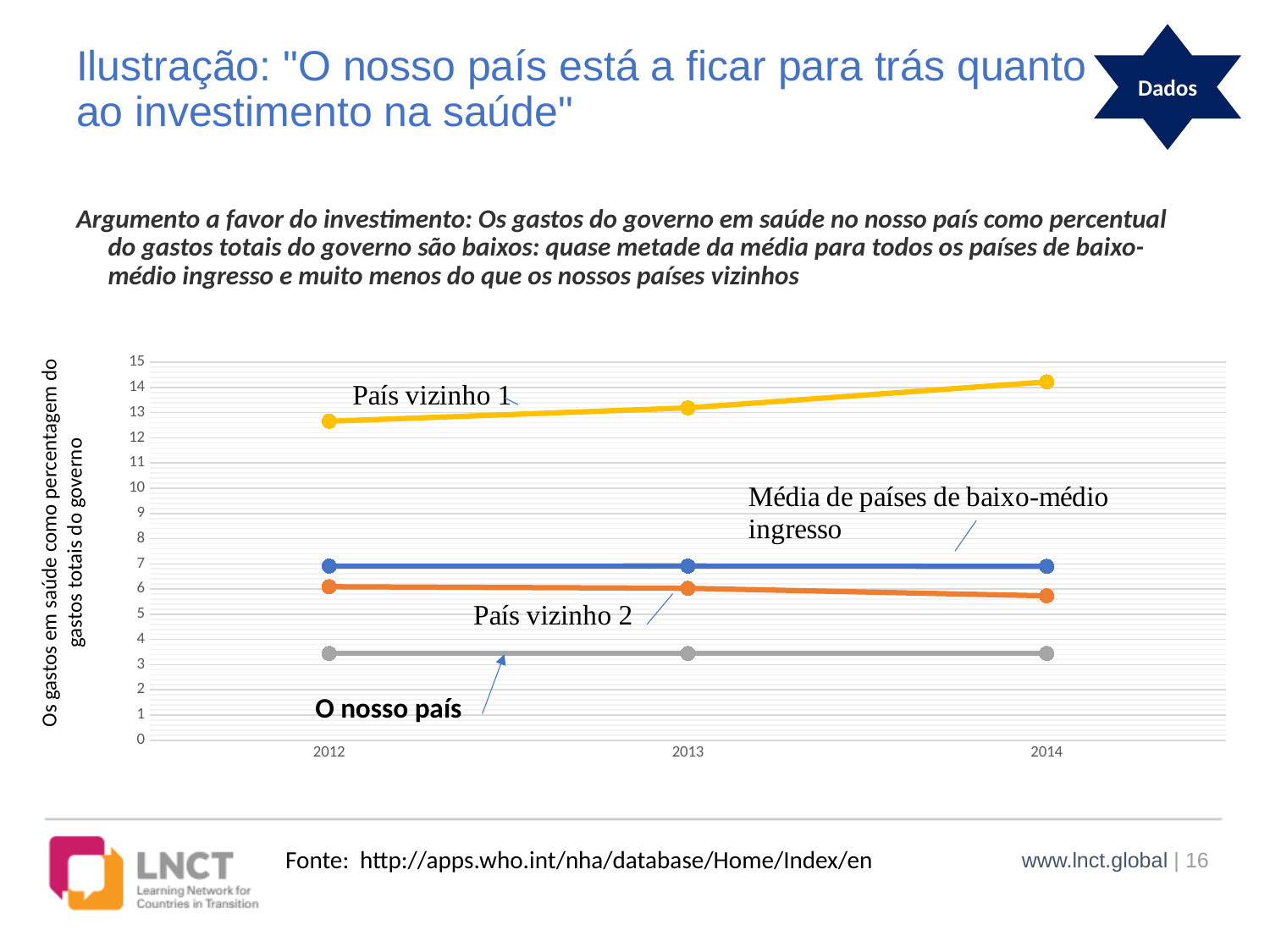
Is the value for O nosso país in 2013 greater or less than 4? less Which series has the lowest value in 2012? O nosso país How many years are shown on the x axis of the chart? 3 Which is larger in 2014: the value for País vizinho 2 or the value for O nosso país? País vizinho 2 Is the value for País vizinho 1 in 2014 greater or less than 14? greater Does the value for País vizinho 1 rise or fall from 2012 to 2014? rise Is the value for Média de países de baixo-médio ingresso in 2014 greater or less than 8? less What is the label on the vertical axis of the chart? Os gastos em saúde como percentagem do gastos totais do governo What kind of chart is shown on the slide? line chart Which is larger in 2012: the value for Média de países de baixo-médio ingresso or the value for País vizinho 1? País vizinho 1 Which series has the highest value in 2014? País vizinho 1